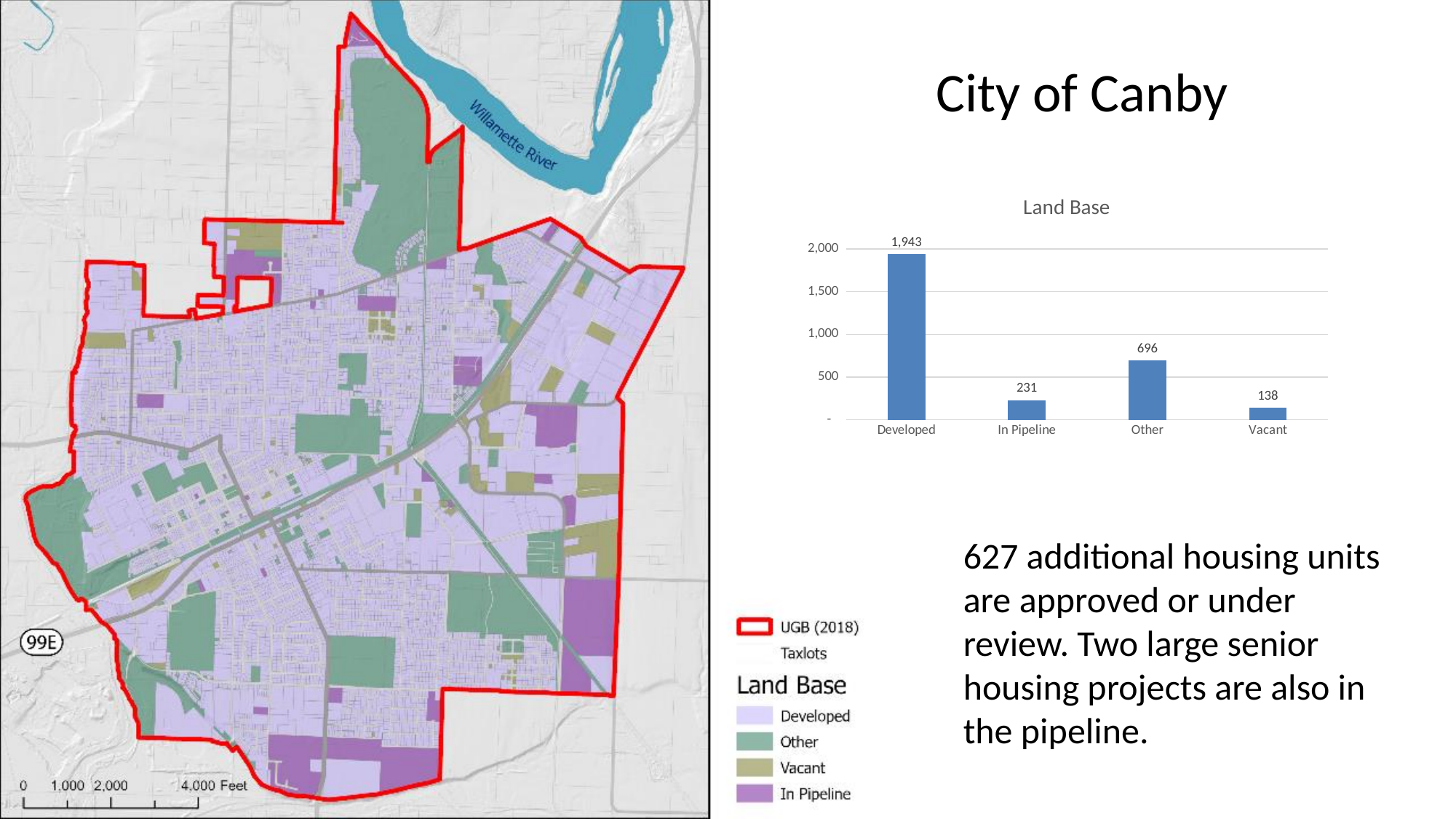
What is the value for In Pipeline in the Land Base chart? 231 What is the value for Other in the Land Base chart? 696 What kind of chart is the Land Base chart? Bar chart Which category has the lowest value in the Land Base chart? Vacant What is the difference between the Developed and Other values in the Land Base chart? 1,247 What is the value for Vacant in the Land Base chart? 138 Is the value for Other in the Land Base chart greater or less than 500? greater Which is larger in the Land Base chart, Other or In Pipeline? Other How many categories are shown in the Land Base chart? 4 Which category has the highest value in the Land Base chart? Developed What is the value for Developed in the Land Base chart? 1,943 What is the difference between the In Pipeline and Vacant values in the Land Base chart? 93